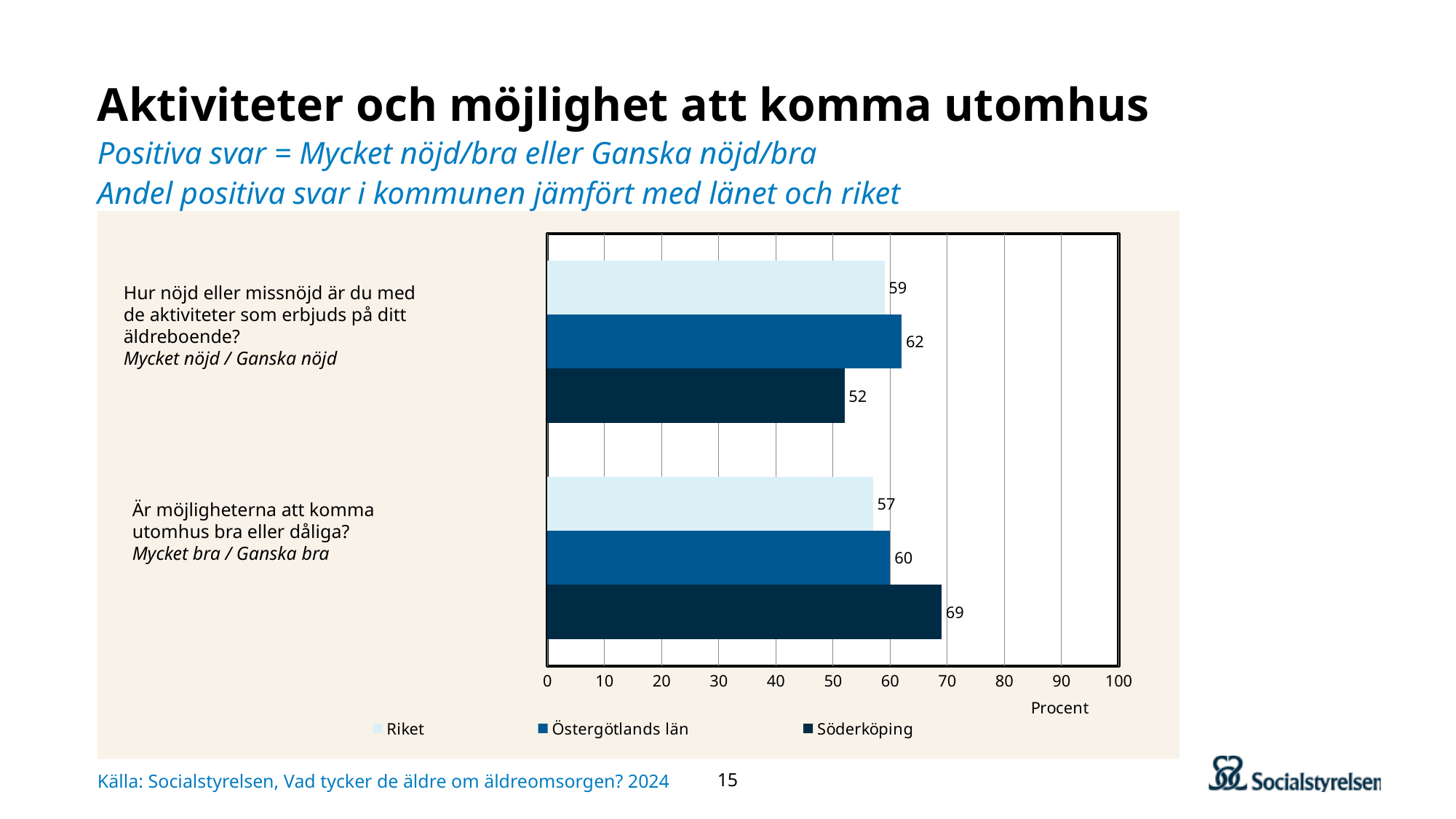
Which is larger: Riket's value for the activities question or Riket's value for the outdoors question? Riket's value for the activities question What kind of chart is shown on the slide? Bar chart What is the value for Östergötlands län on the question about opportunities to get outdoors (Är möjligheterna att komma utomhus bra eller dåliga?)? 60 What unit label is shown under the x axis of the chart? Procent What is the value for Riket on the question about satisfaction with activities offered at the care home (Hur nöjd eller missnöjd är du med de aktiviteter som erbjuds på ditt äldreboende?)? 59 Which series has the highest value on the question about opportunities to get outdoors? Söderköping What is the value for Söderköping on the question about satisfaction with activities offered at the care home? 52 Which series has the lowest value on the question about satisfaction with activities offered at the care home? Söderköping How many series does the legend list? 3 What is the difference between Söderköping and Riket on the question about opportunities to get outdoors? 12 What is the difference between Östergötlands län and Söderköping on the question about satisfaction with activities offered at the care home? 10 What is the value for Söderköping on the question about opportunities to get outdoors? 69